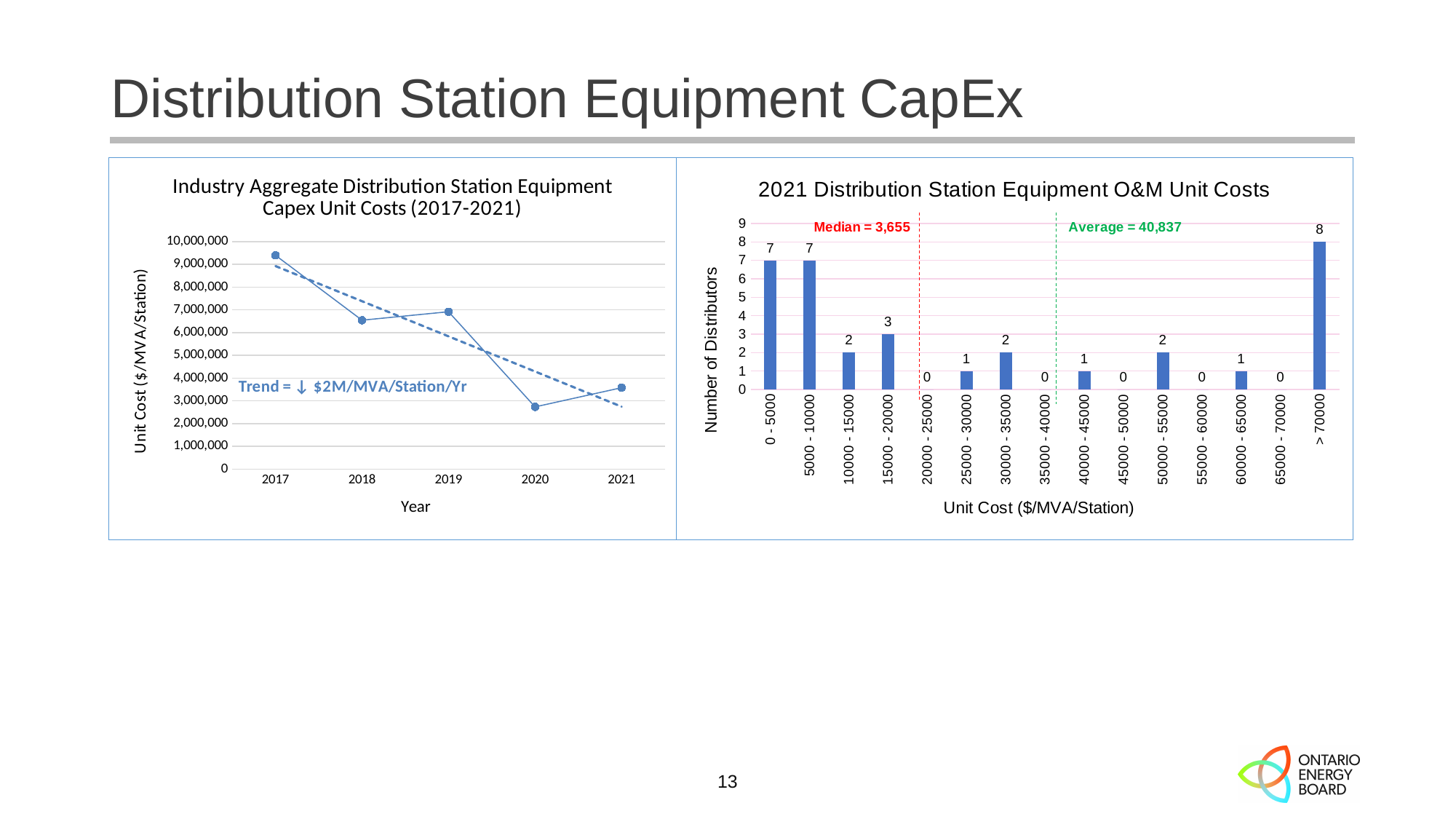
In the right chart, what is the median value stated in the annotation? 3,655 In the left chart, is the unit cost for 2017 greater or less than 9,000,000? greater In the left chart, is the unit cost for 2020 greater or less than 3,000,000? less In the right chart, what is the difference between the number of distributors in the '> 70000' bin and the '0 - 5000' bin? 1 In the left chart, which year has the lowest unit cost? 2020 In the left chart, what trend is stated in the annotation? ↓ $2M/MVA/Station/Yr In the left chart, which year has the highest unit cost? 2017 In the right chart, which unit cost bin has the most distributors? > 70000 In the right chart, how many unit cost bins are shown on the x axis? 15 In the left chart, do unit costs generally rise or fall from 2017 to 2021? Fall What kind of chart is the left chart, 'Industry Aggregate Distribution Station Equipment Capex Unit Costs (2017-2021)'? Line chart In the right chart, '2021 Distribution Station Equipment O&M Unit Costs', how many distributors are in the '> 70000' bin? 8